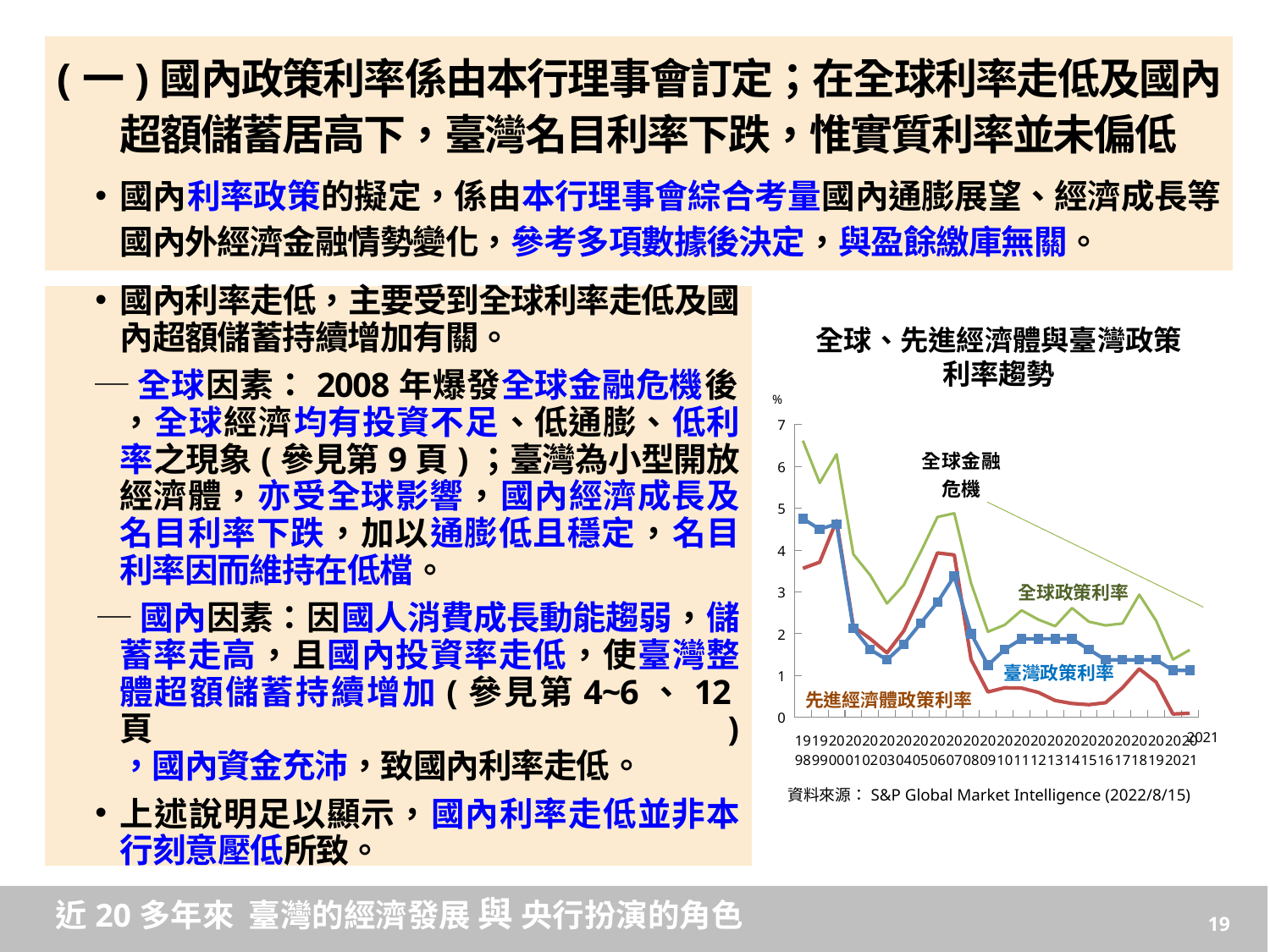
What is the data source cited below the chart? S&P Global Market Intelligence (2022/8/15) What kind of chart is shown on the slide? line chart In 2015, which is larger: 臺灣政策利率 or 先進經濟體政策利率? 臺灣政策利率 In 1998, which is larger: 全球政策利率 or 臺灣政策利率? 全球政策利率 Is the value of 先進經濟體政策利率 in 2021 greater or less than 1? less How many years are labelled along the x axis of the chart? 24 Is the value of 全球政策利率 in 1998 greater or less than 6? greater Overall, does 臺灣政策利率 rise or fall from 1998 to 2021? fall What is the title of the chart? 全球、先進經濟體與臺灣政策利率趨勢 Is the value of 臺灣政策利率 in 2021 greater or less than 2? less How many series are plotted in the chart? 3